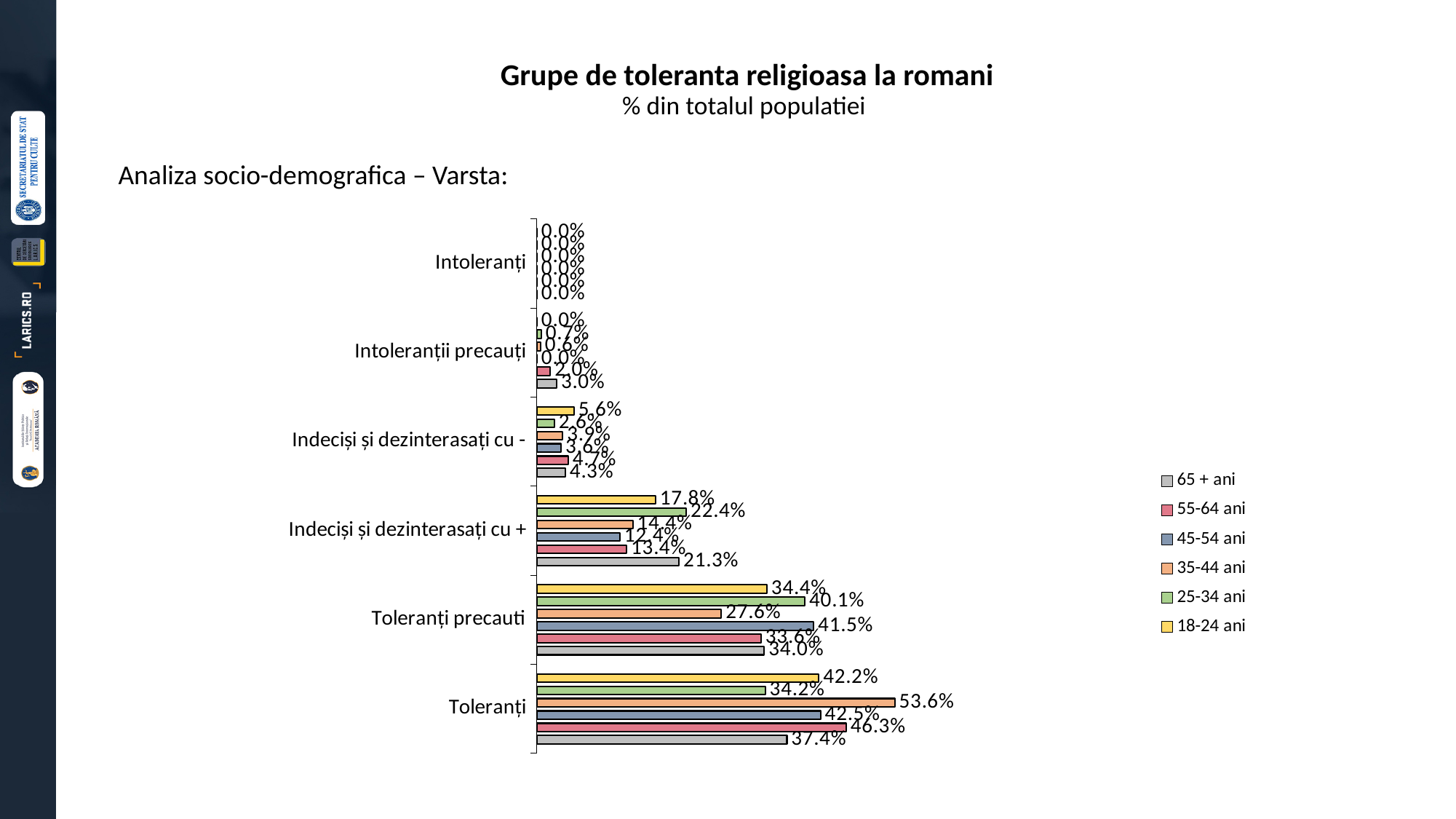
Which age group has the highest value in the Toleranți category? 35-44 ani How many categories are shown on the vertical axis? 6 In the Toleranți precauti category, which is larger: the 45-54 ani value or the 25-34 ani value? 45-54 ani What is the difference between the 55-64 ani and 65 + ani values in the Toleranți category? 8.9% What is the value for the 35-44 ani series in the Toleranți category? 53.6% What is the value for the 35-44 ani series in the Toleranți precauti category? 27.6% What is the subtitle shown under the chart title? % din totalul populatiei What is the value for the 65 + ani series in the Indeciși și dezinterasați cu + category? 21.3% What kind of chart is shown on the slide? bar chart What is the value for the 65 + ani series in the Toleranți category? 37.4% Which age group has the lowest value in the Toleranți precauti category? 35-44 ani How many series does the legend list? 6